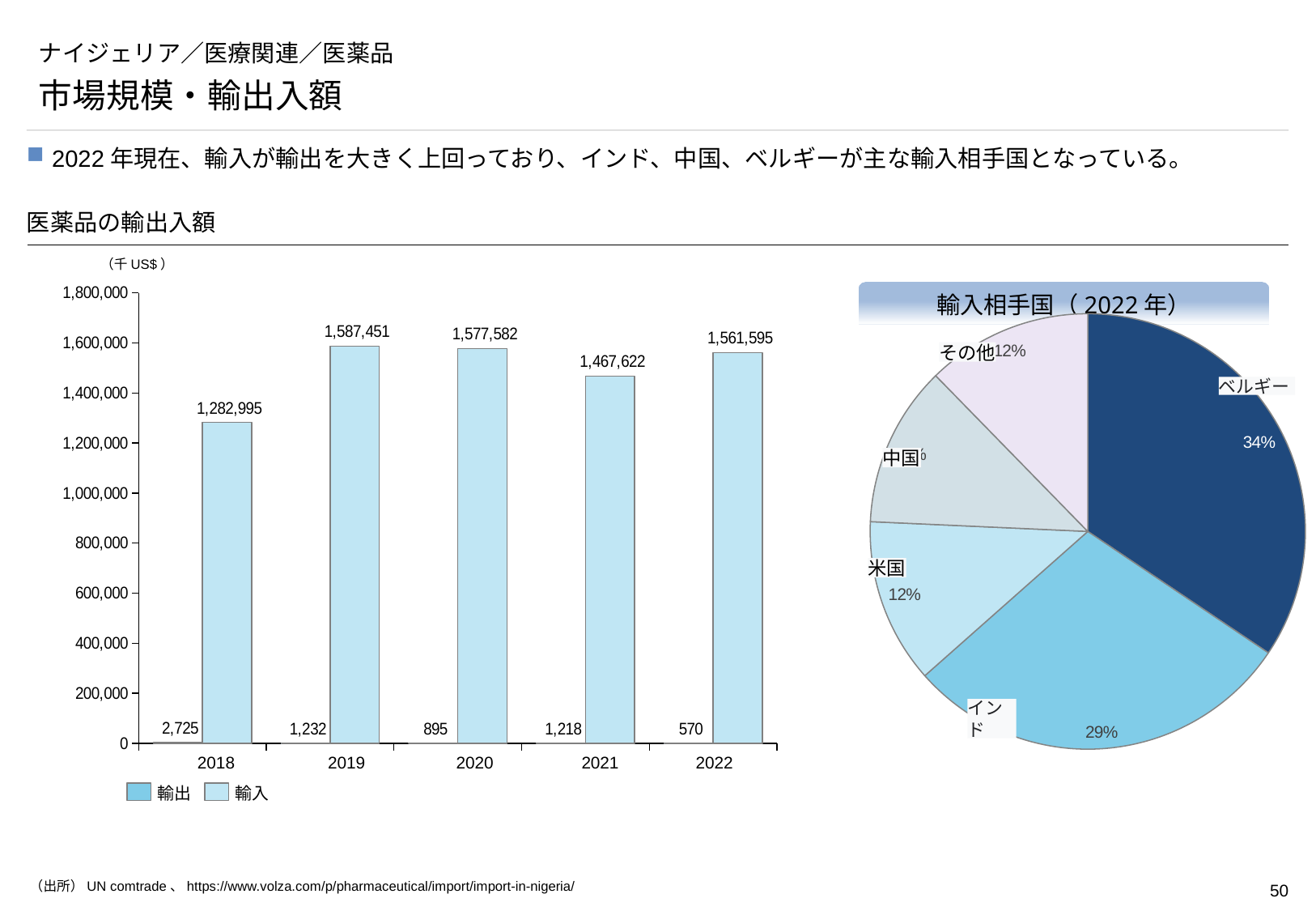
In the bar chart 医薬品の輸出入額, how many series does the legend list? 2 In the pie chart 輸入相手国（2022年）, what share does ベルギー have? 34% In the bar chart 医薬品の輸出入額, what is the 輸入 value for 2018? 1,282,995 In the bar chart 医薬品の輸出入額, what is the 輸入 value for 2019? 1,587,451 In the bar chart 医薬品の輸出入額, which year has the highest 輸入 value? 2019 In the bar chart 医薬品の輸出入額, what is the 輸出 value for 2022? 570 In the pie chart 輸入相手国（2022年）, which country has the largest share? ベルギー In the bar chart 医薬品の輸出入額, how many years are shown on the x axis? 5 In the bar chart 医薬品の輸出入額, what is the difference between the 輸入 values for 2022 and 2021? 93,973 In the bar chart 医薬品の輸出入額, is the 輸入 value for 2018 greater or less than the 輸入 value for 2020? less In the bar chart 医薬品の輸出入額, which year has the lowest 輸出 value? 2022 What kind of chart is 医薬品の輸出入額? bar chart